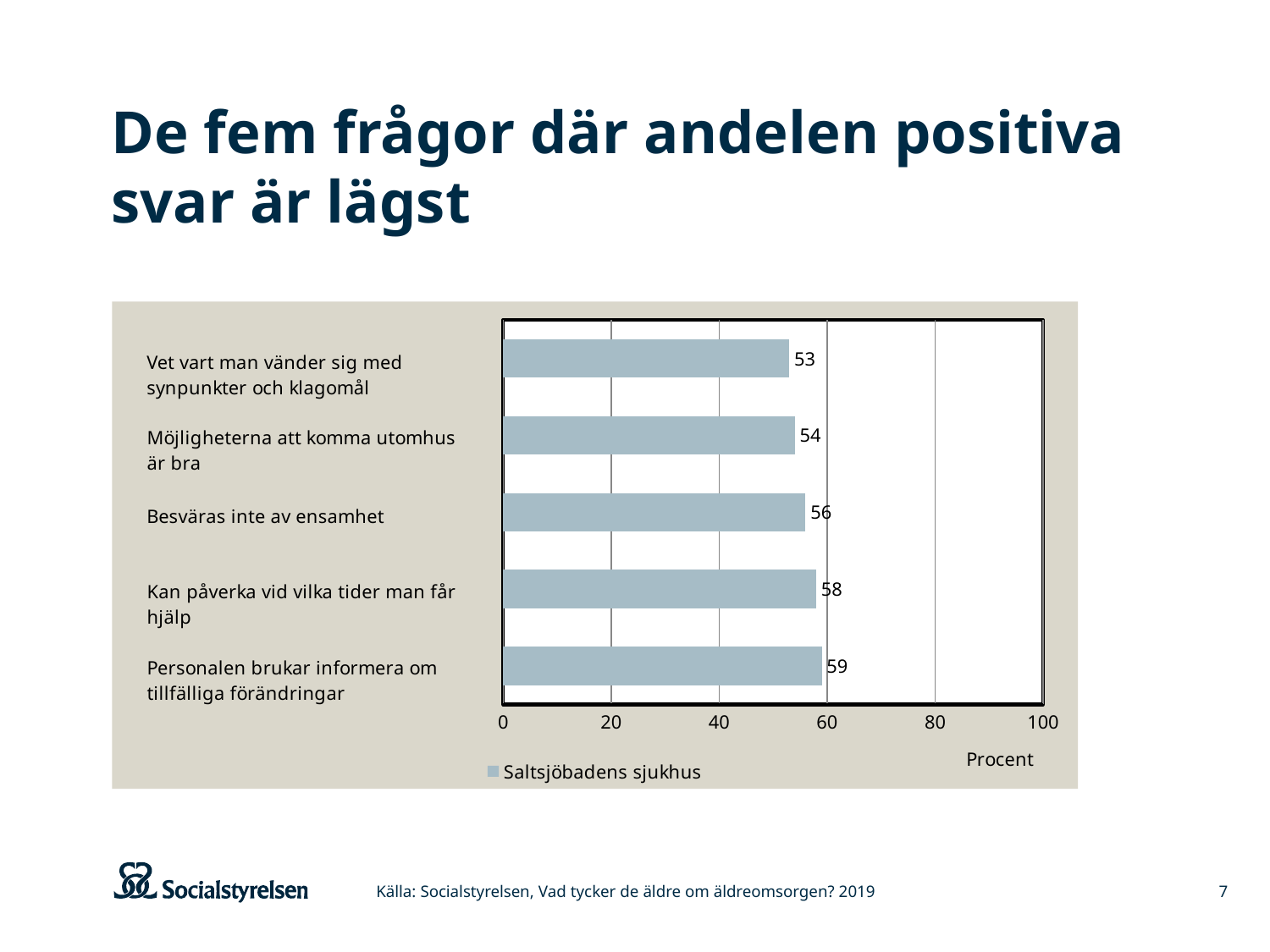
What is the value for "Vet vart man vänder sig med synpunkter och klagomål"? 53 How many categories are shown in the chart? 5 How many series does the legend list? 1 Which category has the highest value? Personalen brukar informera om tillfälliga förändringar Is the value for "Möjligheterna att komma utomhus är bra" greater or less than 60? less What is the difference between the values for "Personalen brukar informera om tillfälliga förändringar" and "Vet vart man vänder sig med synpunkter och klagomål"? 6 What is the value for "Personalen brukar informera om tillfälliga förändringar"? 59 Which is larger: the value for "Kan påverka vid vilka tider man får hjälp" or the value for "Möjligheterna att komma utomhus är bra"? Kan påverka vid vilka tider man får hjälp What is the name of the series shown in the legend? Saltsjöbadens sjukhus What is the value for "Besväras inte av ensamhet"? 56 What kind of chart is shown on the slide? bar chart Which category has the lowest value? Vet vart man vänder sig med synpunkter och klagomål